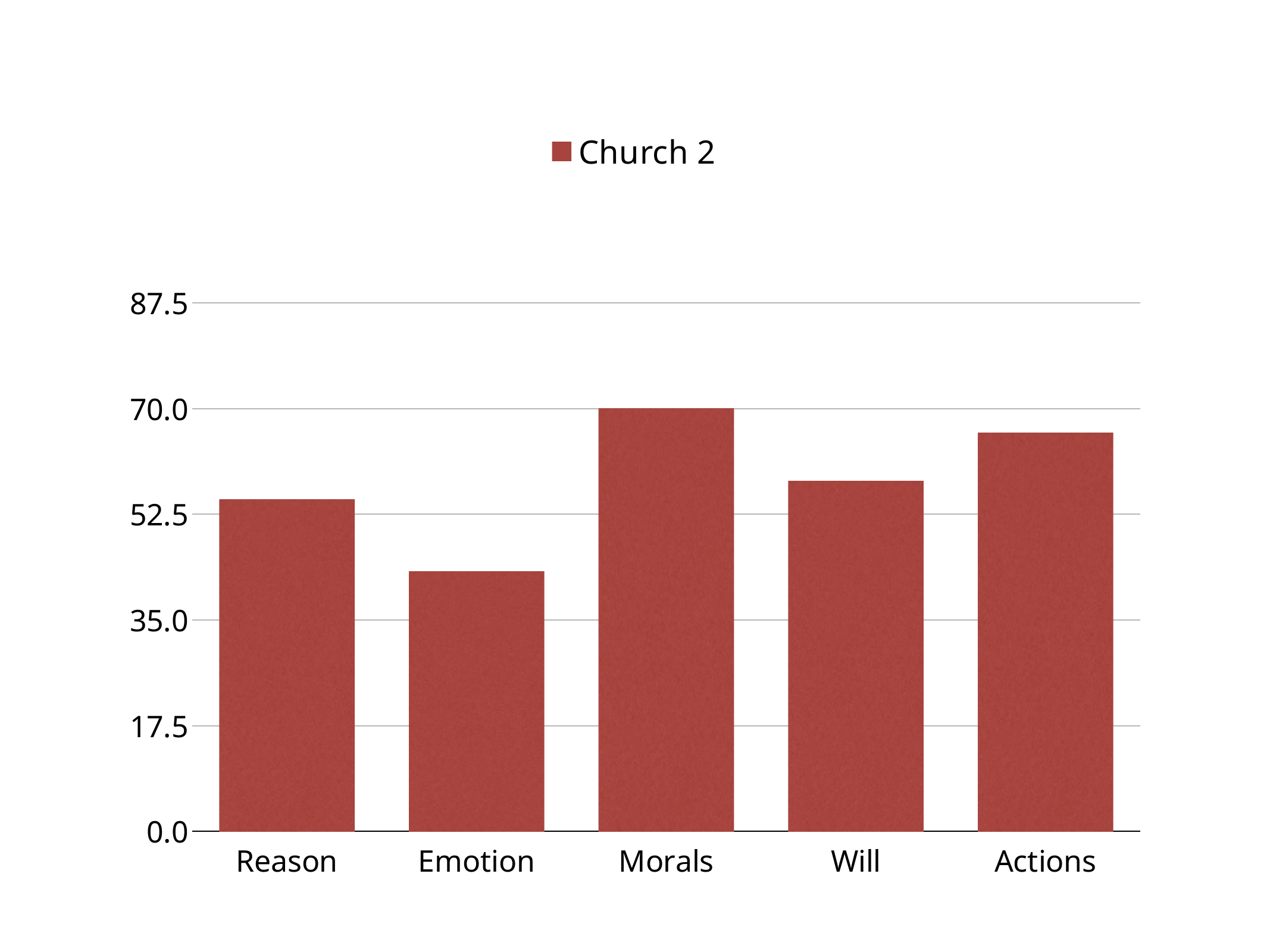
What is the value for Morals? 70.0 Which is larger, the value for Emotion or the value for Reason? Reason Which is larger, the value for Actions or the value for Will? Actions Is the value for Emotion greater or less than 52.5? less Which category has the lowest value? Emotion Which category has the highest value? Morals Is the value for Actions greater or less than 70.0? less What is the name of the series shown in the legend? Church 2 How many categories are shown on the x axis? 5 What kind of chart is shown on the slide? bar chart How many series does the legend list? 1 Is the value for Reason greater or less than 52.5? greater